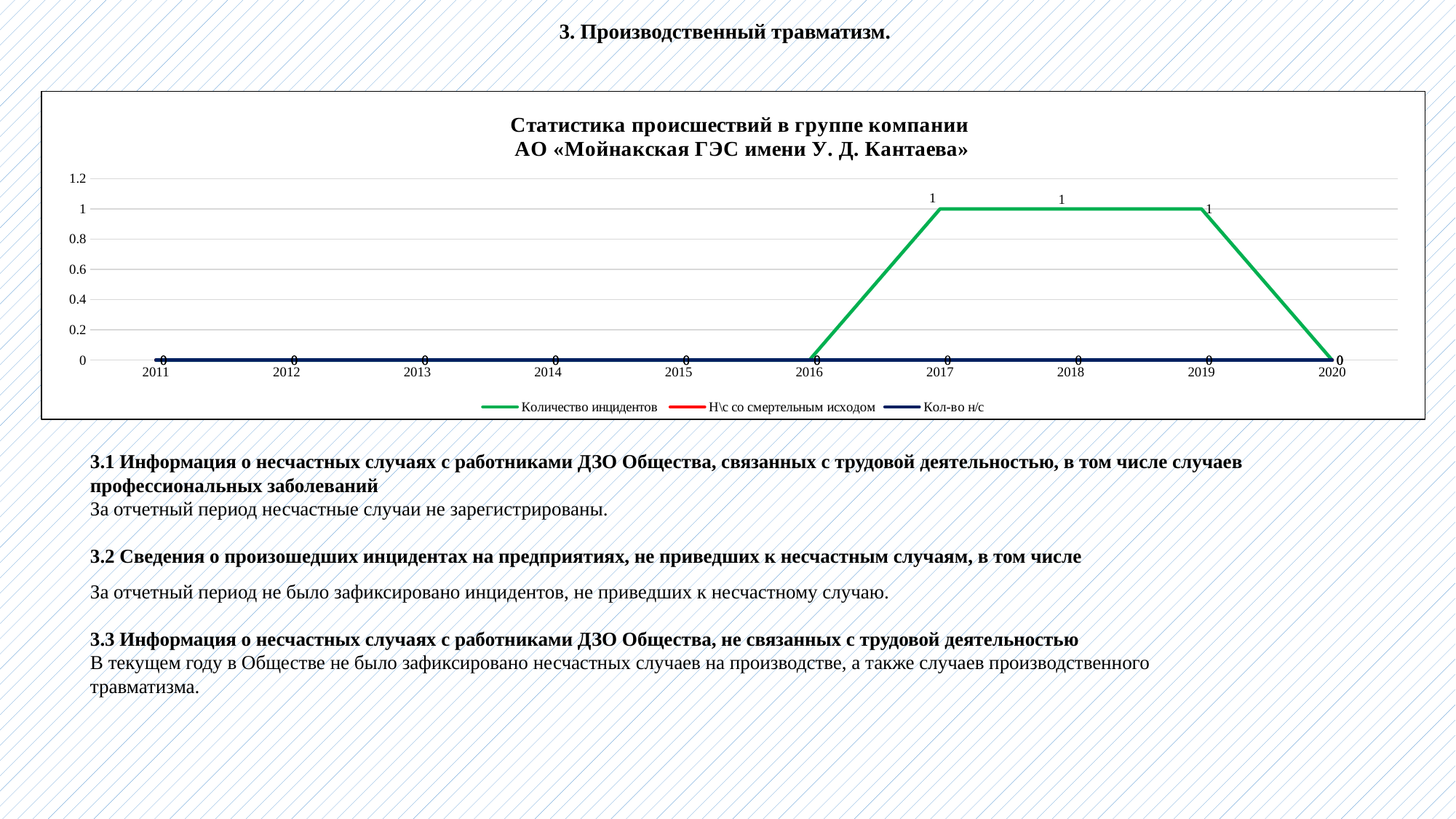
What is the difference between the "Количество инцидентов" values for 2018 and 2015? 1 What is the value of "Количество инцидентов" in 2016? 0 Which colour is used for the "Количество инцидентов" series? green What kind of chart is shown on the slide? line chart How many years are shown on the x axis? 10 What is the value of "Кол-во н/с" in 2019? 0 How does the "Количество инцидентов" line change from 2019 to 2020? falls How many series does the legend list? 3 What is the value of "Количество инцидентов" in 2017? 1 Which is larger, the "Количество инцидентов" value for 2019 or for 2020? 2019 What is the first year on the x axis? 2011 What is the value of "Количество инцидентов" in 2020? 0